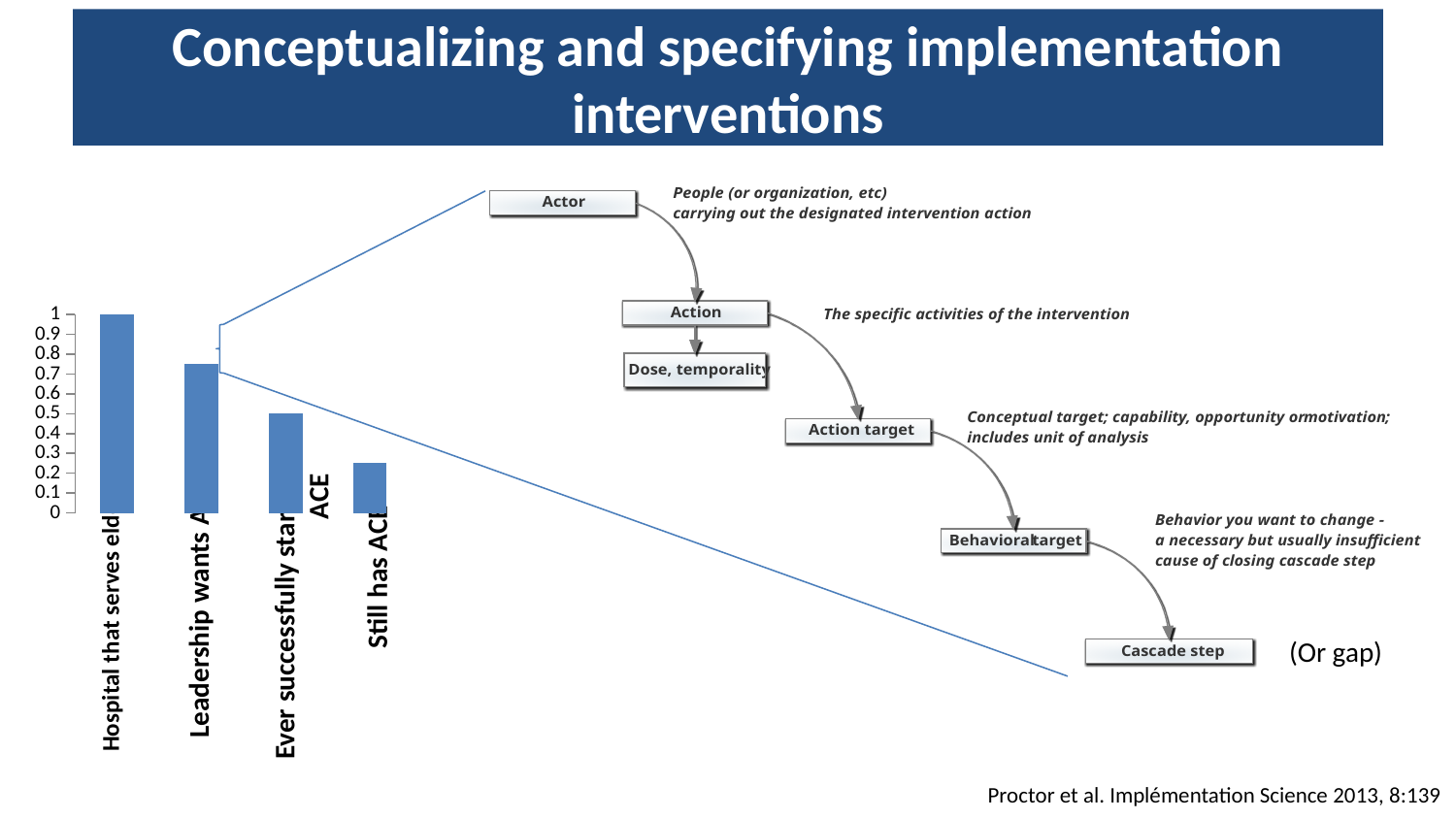
What is the value of the leftmost bar in the bar chart? 1 How many bars does the bar chart on the left of the slide have? 4 What kind of chart is shown on the left of the slide? bar chart What colour are the bars in the bar chart? blue Do the bar values rise or fall from left to right along the x axis? fall What is the difference between the value of the leftmost bar and the third bar from the left in the bar chart? 0.5 Which category in the bar chart has the lowest value? Still has ACE Is the value for Still has ACE greater or less than 0.3? less Which is larger in the bar chart: the second bar from the left or the third bar from the left? the second bar from the left Which bar in the bar chart is the tallest? the leftmost bar (Hospital that serves eld…) Is the value of the second bar from the left in the bar chart greater or less than 0.7? greater What is the value of the third bar from the left in the bar chart? 0.5